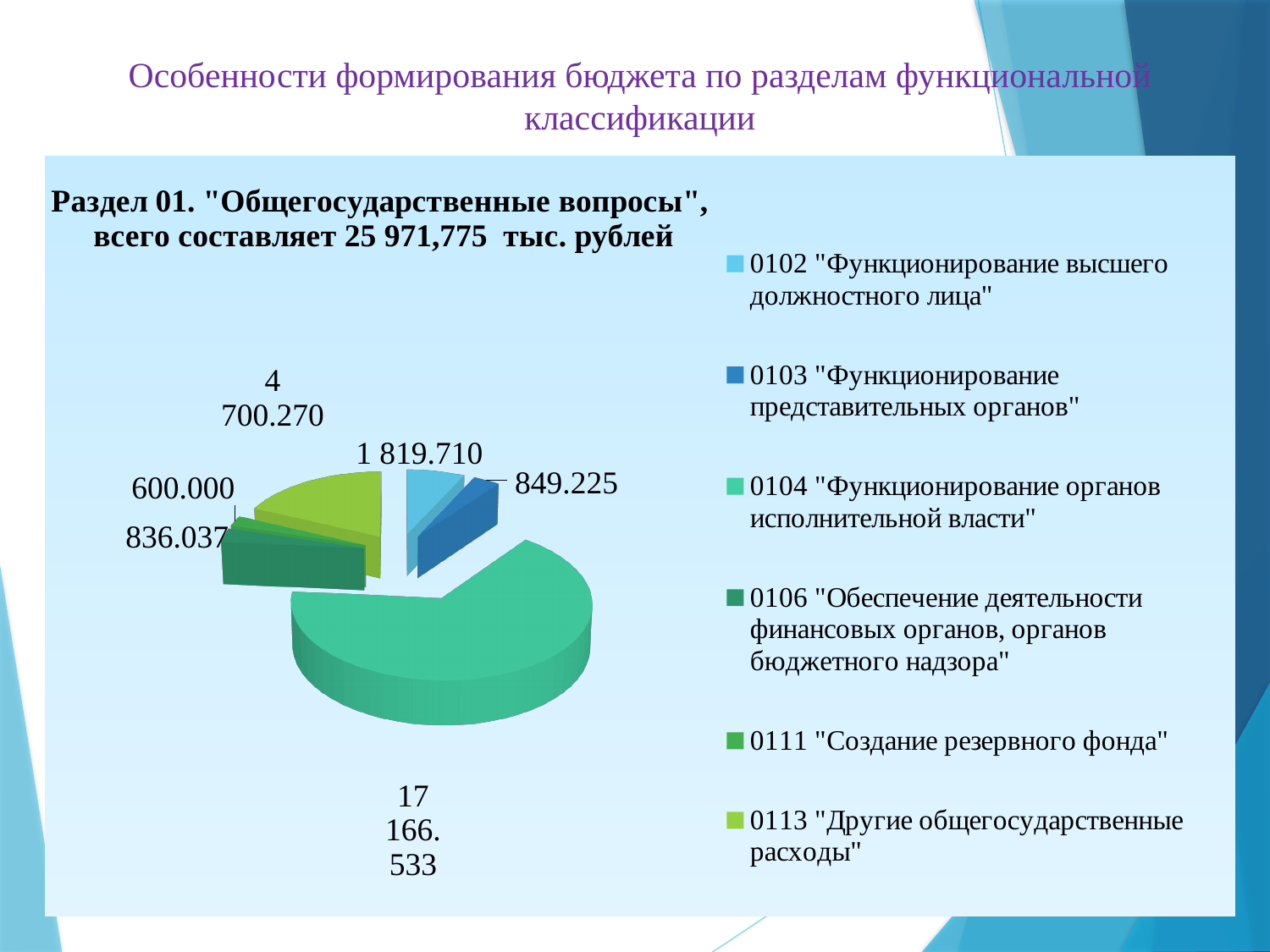
Which is larger, the slice for 0113 or the slice for 0102? 0113 What is the value of the slice for 0104 "Функционирование органов исполнительной власти"? 17 166.533 What is the value of the slice for 0111 "Создание резервного фонда"? 600.000 What is the value of the slice for 0102 "Функционирование высшего должностного лица"? 1 819.710 Which category has the smallest slice in the pie chart? 0111 "Создание резервного фонда" What type of chart is shown on the slide? Pie chart What is the difference between the values for 0102 and 0103? 970.485 What is the value of the slice for 0113 "Другие общегосударственные расходы"? 4 700.270 Which category has the largest slice in the pie chart? 0104 "Функционирование органов исполнительной власти" What is the difference between the values for 0106 and 0111? 236.037 What total amount does the chart title state for Раздел 01? 25 971,775 тыс. рублей How many slices does the pie chart have? 6